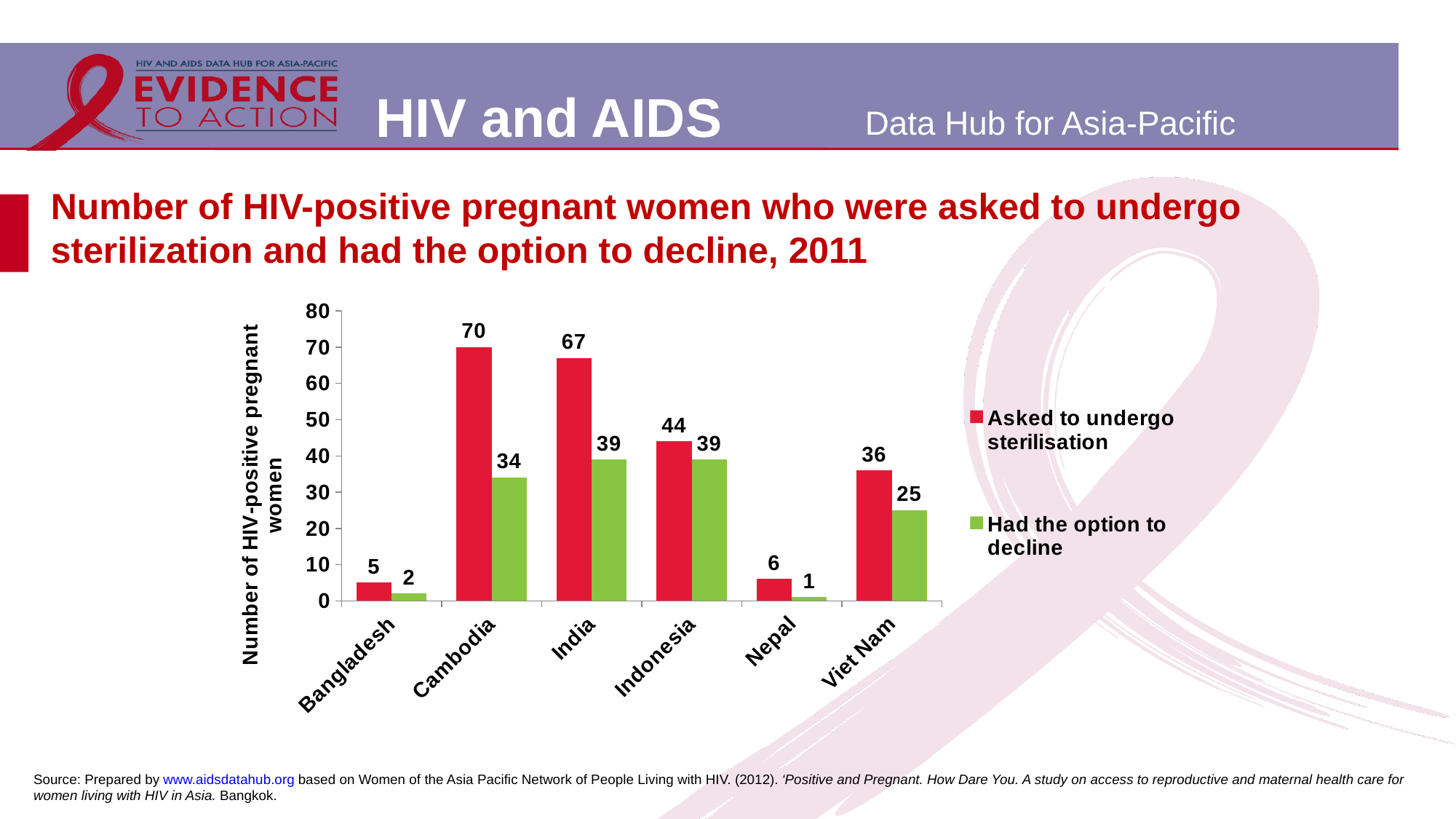
What colour represents the 'Asked to undergo sterilisation' series? Red What is the value for Nepal in the 'Had the option to decline' series? 1 How many HIV-positive pregnant women in Viet Nam had the option to decline? 25 How many series does the legend list? 2 How many HIV-positive pregnant women in Cambodia were asked to undergo sterilisation? 70 Which is larger: the number asked to undergo sterilisation in Indonesia or in Viet Nam? Indonesia How many countries are shown on the x axis? 6 What is the difference between the number asked to undergo sterilisation and the number who had the option to decline in India? 28 Which country has the highest number of women asked to undergo sterilisation? Cambodia Is the value for Cambodia in the 'Had the option to decline' series greater or less than 30? greater What kind of chart is shown on the slide? Bar chart Which country has the lowest number of women who had the option to decline? Nepal